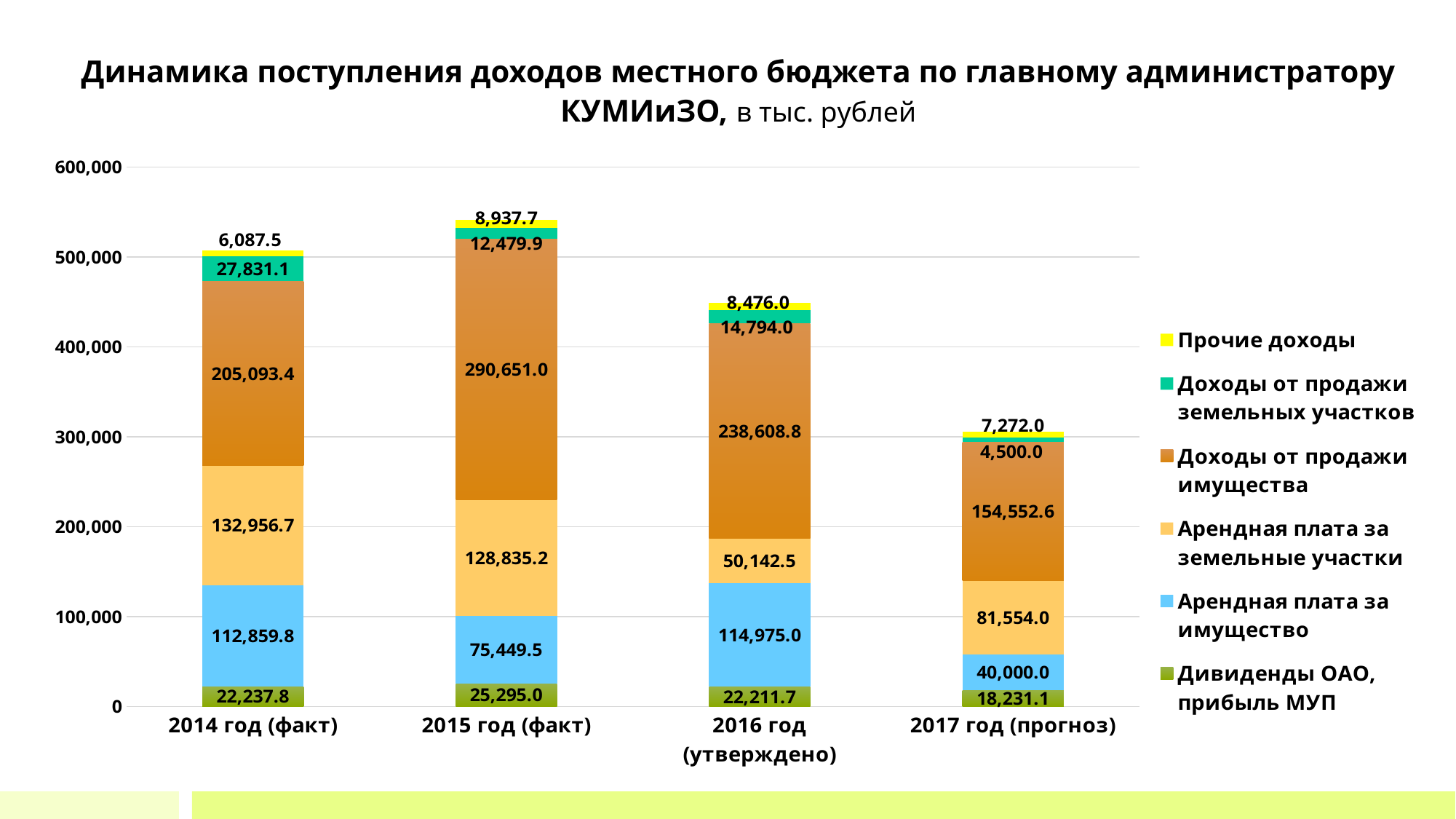
What is the value of 'Арендная плата за имущество' for 2016 год (утверждено)? 114,975.0 What is the value of 'Доходы от продажи имущества' for 2015 год (факт)? 290,651.0 How many series does the legend list? 6 In which year is the value of 'Доходы от продажи земельных участков' the highest? 2014 год (факт) What is the total of the stacked bar for 2017 год (прогноз)? 306,109.7 What is the value of 'Прочие доходы' for 2014 год (факт)? 6,087.5 What is the difference between the 'Доходы от продажи имущества' values for 2015 год (факт) and 2014 год (факт)? 85,557.6 What is the value of 'Дивиденды ОАО, прибыль МУП' for 2017 год (прогноз)? 18,231.1 How many categories (years) are shown on the x axis? 4 In which year is the value of 'Арендная плата за земельные участки' the lowest? 2016 год (утверждено) What kind of chart is shown on the slide? Stacked bar chart Which is larger: 'Арендная плата за имущество' in 2014 год (факт) or in 2015 год (факт)? 2014 год (факт)